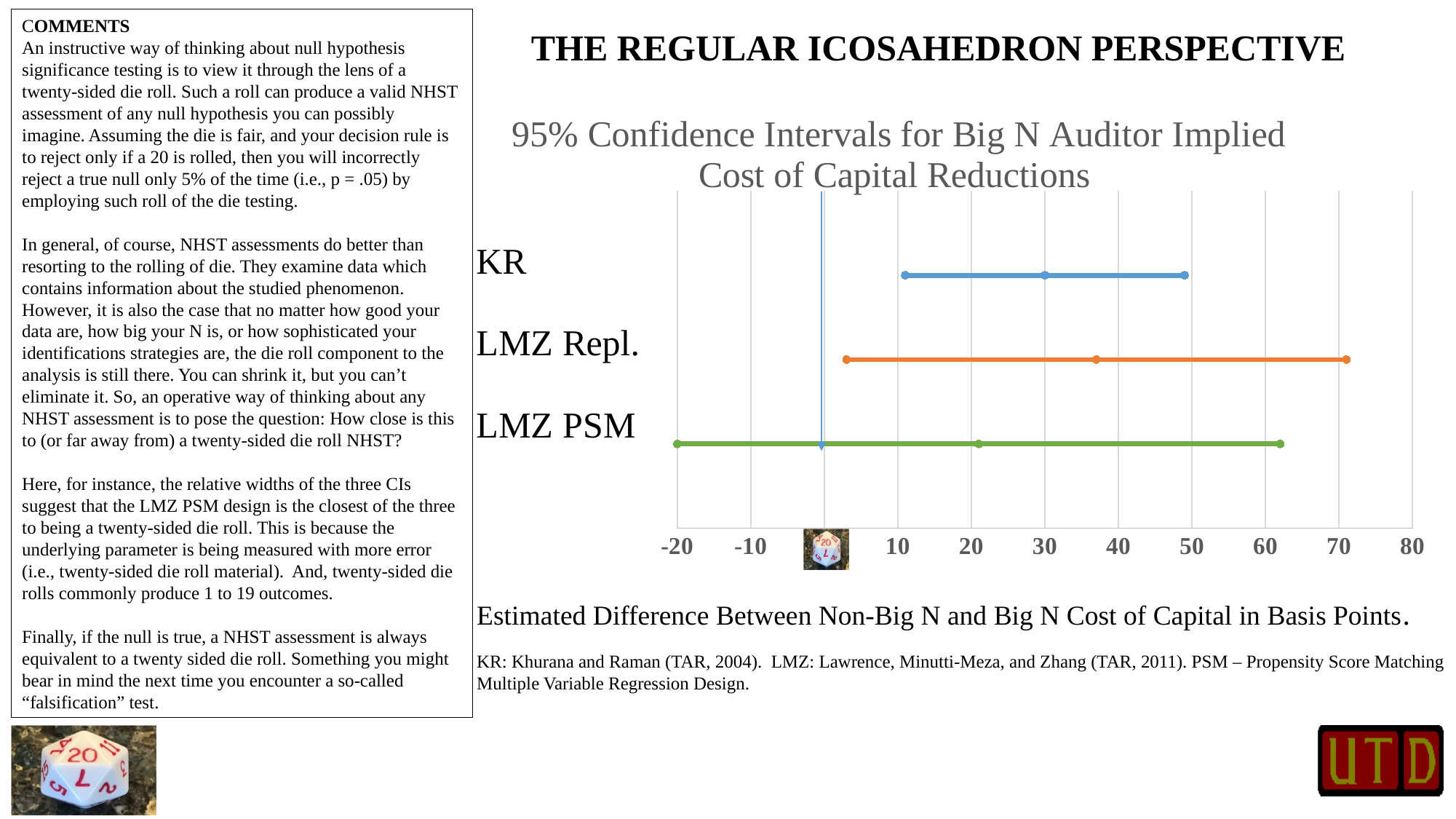
What is the title of the chart? 95% Confidence Intervals for Big N Auditor Implied Cost of Capital Reductions How many confidence intervals (categories) are plotted on the chart? 3 Is the lower end of the LMZ Repl. interval greater or less than 0? greater Is the midpoint marker of the KR interval greater or less than 20? greater What is the lowest value shown on the chart's x axis? -20 Which category's interval extends to the lowest value on the x axis? LMZ PSM Is the upper end of the LMZ PSM interval greater or less than 60? greater Which category has the widest confidence interval on the chart? LMZ PSM Which category's interval reaches the highest value on the x axis? LMZ Repl. Which has a higher midpoint marker, LMZ Repl. or LMZ PSM? LMZ Repl. Which category has the narrowest confidence interval on the chart? KR